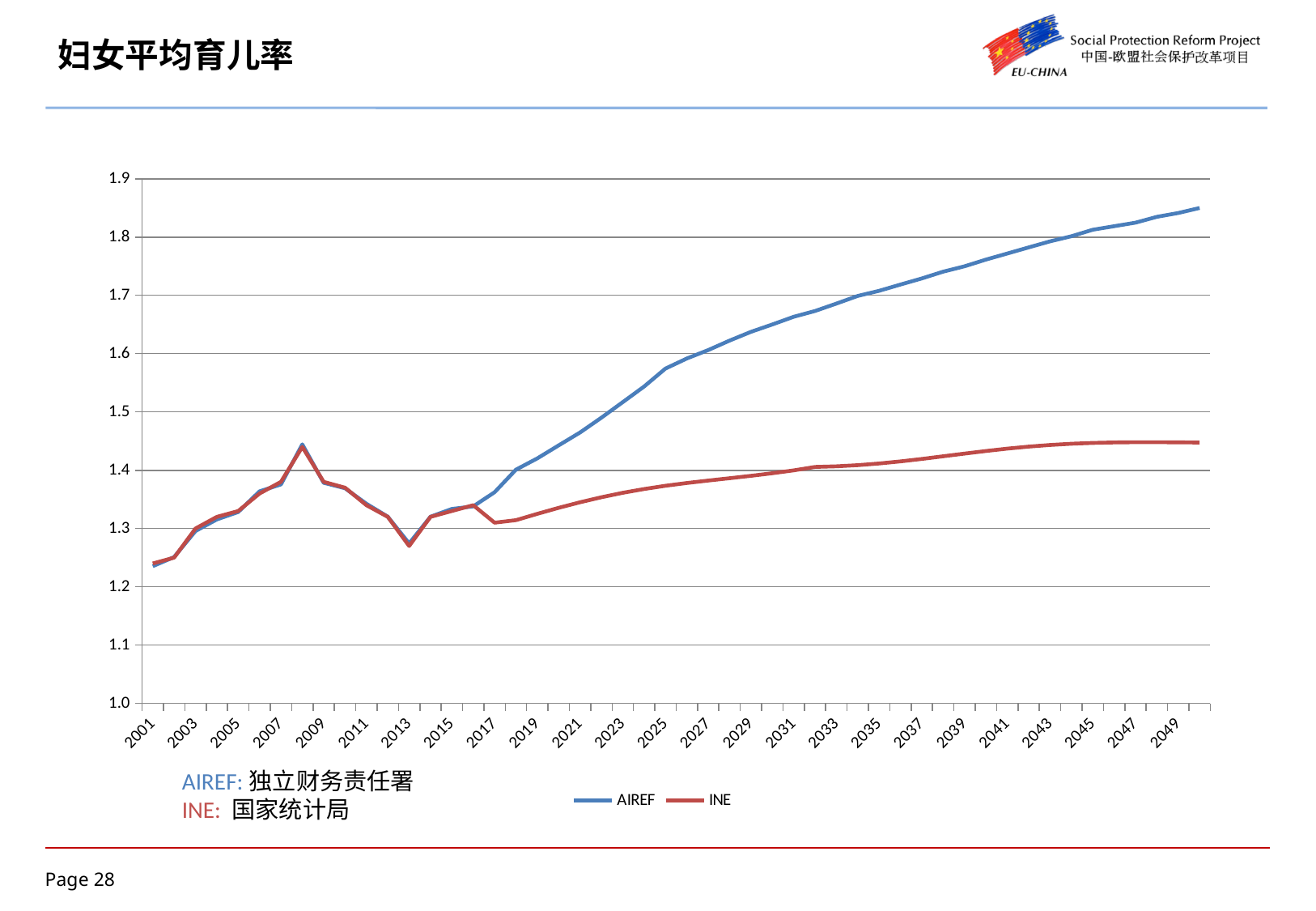
How many year labels are shown on the x axis? 25 In 2049, which series has the higher value, AIREF or INE? AIREF Which series is drawn in blue? AIREF How many series does the legend list? 2 Is the INE value for 2049 greater or less than 1.5? less Is the AIREF value for 2025 greater or less than 1.5? greater Is the AIREF value for 2001 greater or less than 1.3? less What are the two series named in the legend? AIREF and INE What kind of chart is shown on the slide? line chart Does the AIREF series rise or fall from 2017 to 2049? rise